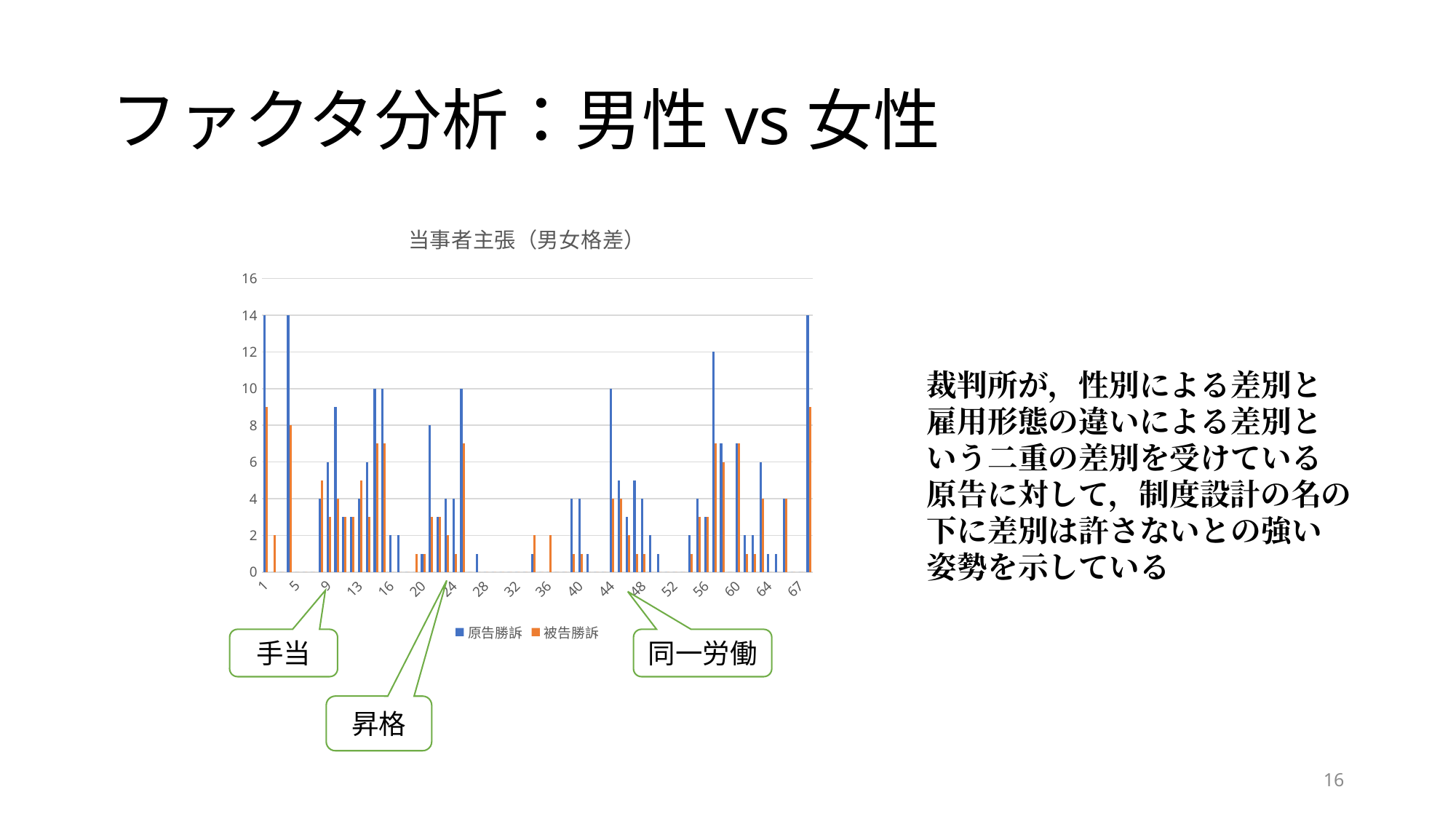
Is the value for 被告勝訴 at category 1 greater or less than 6? greater What is the value of 原告勝訴 at category 1? 14 What is the title of the chart? 当事者主張（男女格差） What is the value of 原告勝訴 at category 44? 10 What is the highest value reached by the 原告勝訴 series? 14 How many series does the chart legend list? 2 Which series is shown in orange in the chart? 被告勝訴 At category 1, which is larger, 原告勝訴 or 被告勝訴? 原告勝訴 What kind of chart is shown on the slide? bar chart